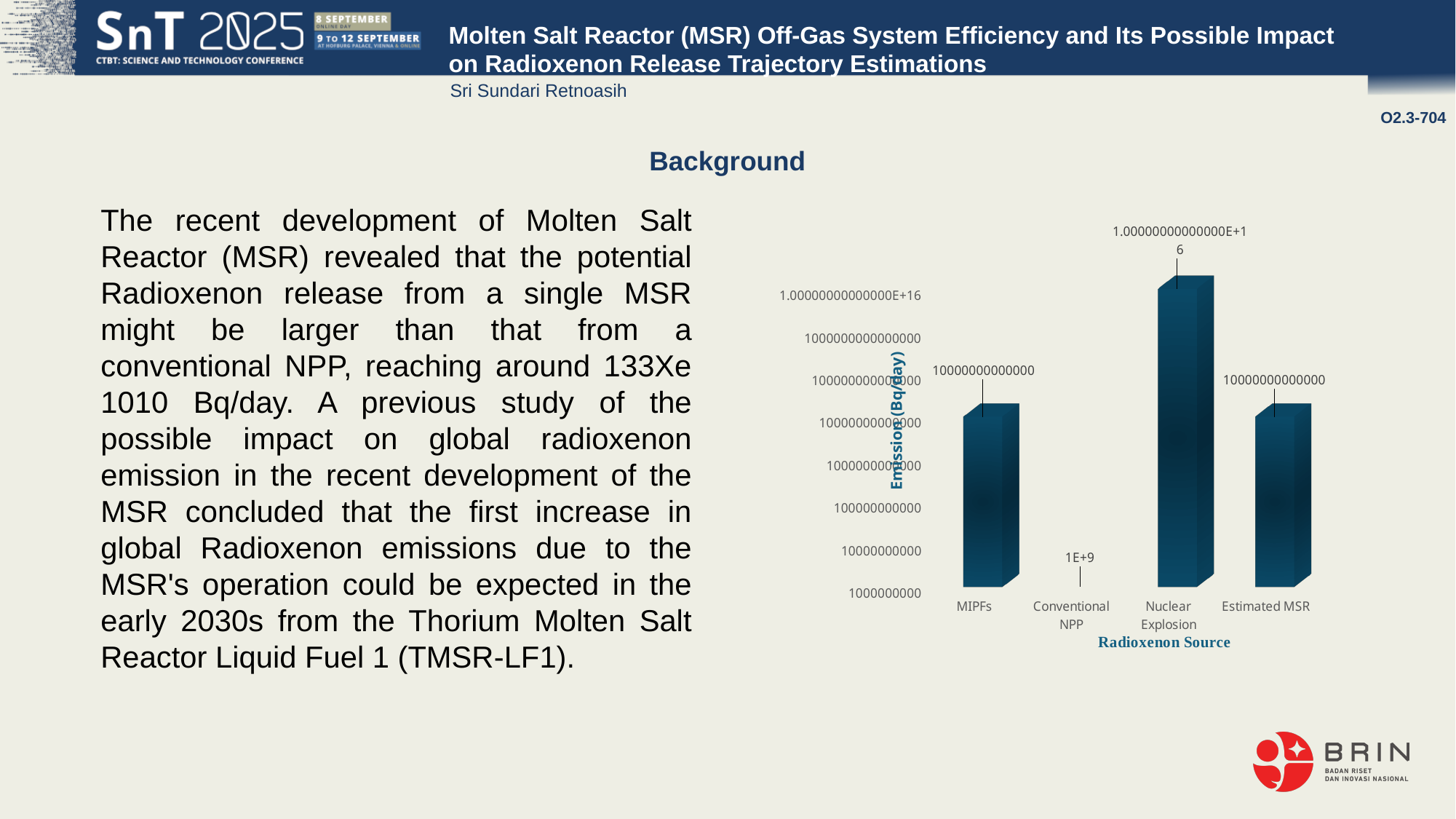
Which has a larger emission value, Nuclear Explosion or Estimated MSR? Nuclear Explosion Which radioxenon source has the lowest emission value? Conventional NPP What is the emission value shown for MIPFs? 10000000000000 What is the title of the y axis of the chart? Emission (Bq/day) Which has a larger emission value, Conventional NPP or MIPFs? MIPFs What is the emission value shown for Estimated MSR? 10000000000000 What is the emission value shown for Conventional NPP? 1E+9 How many radioxenon sources are shown on the x axis of the chart? 4 Is the value for Conventional NPP greater or less than 10000000000? less What kind of chart is shown on the slide? Bar chart What is the emission value shown for Nuclear Explosion? 1.00000000000000E+16 Which radioxenon source has the highest emission value? Nuclear Explosion